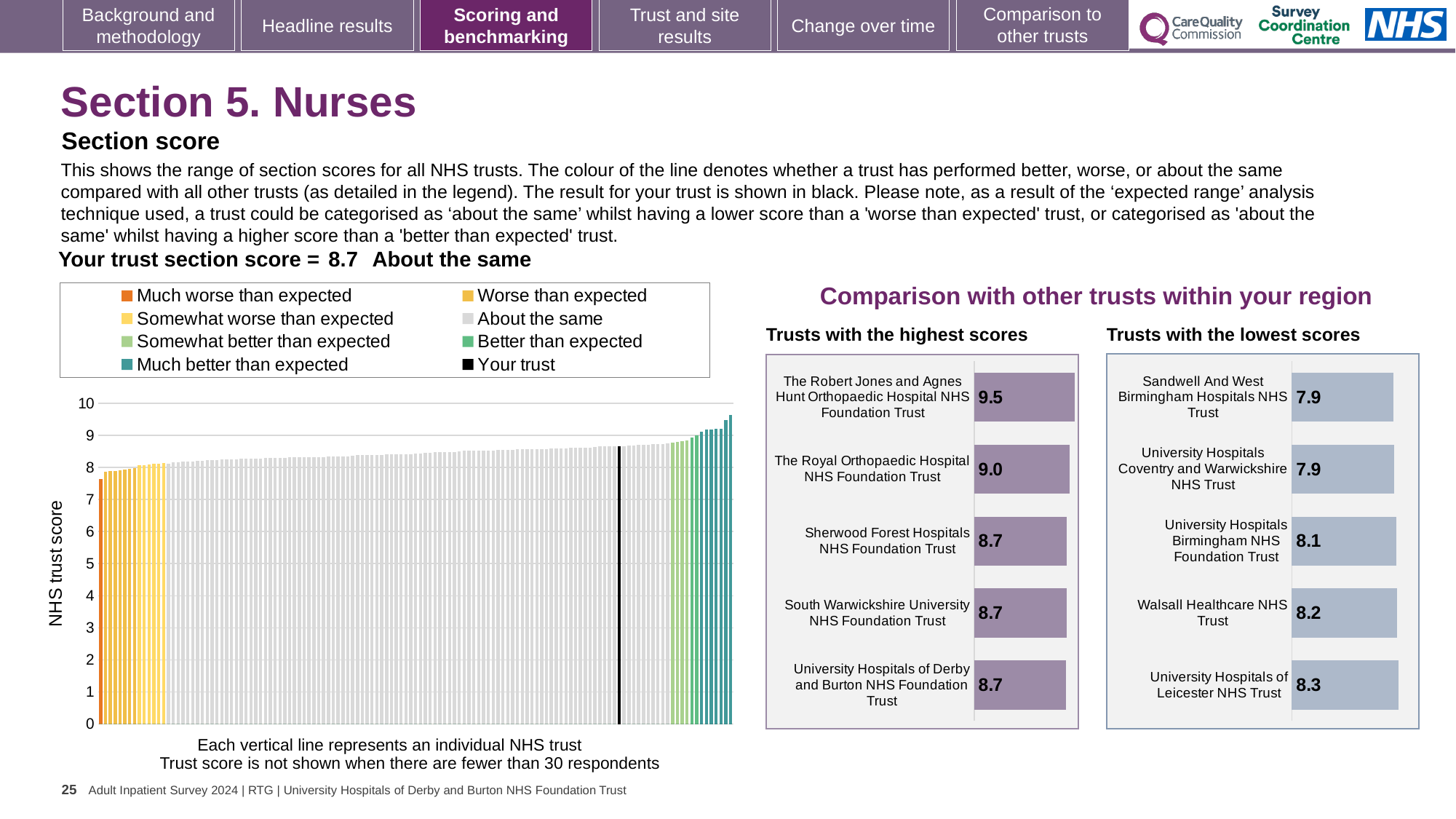
In the 'Trusts with the lowest scores' chart, which trust has the highest score shown? University Hospitals of Leicester NHS Trust In the 'Trusts with the lowest scores' chart, what is the score for University Hospitals of Leicester NHS Trust? 8.3 In the 'Trusts with the highest scores' chart, what is the score for The Royal Orthopaedic Hospital NHS Foundation Trust? 9.0 In the main 'NHS trust score' chart, do the values rise or fall from left to right? Rise In the 'Trusts with the lowest scores' chart, which has the larger score: University Hospitals Birmingham NHS Foundation Trust or Walsall Healthcare NHS Trust? Walsall Healthcare NHS Trust How many trusts are listed in the 'Trusts with the highest scores' chart? 5 In the 'Trusts with the highest scores' chart, which trust has the highest score? The Robert Jones and Agnes Hunt Orthopaedic Hospital NHS Foundation Trust In the 'Trusts with the highest scores' chart, what is the difference between the scores of The Robert Jones and Agnes Hunt Orthopaedic Hospital NHS Foundation Trust and The Royal Orthopaedic Hospital NHS Foundation Trust? 0.5 How many entries does the legend of the main 'NHS trust score' chart list? 8 In the 'Trusts with the highest scores' chart, what is the score for The Robert Jones and Agnes Hunt Orthopaedic Hospital NHS Foundation Trust? 9.5 In the 'Trusts with the lowest scores' chart, what is the score for Walsall Healthcare NHS Trust? 8.2 What kind of chart is the main 'NHS trust score' chart on the left of the slide? Bar chart